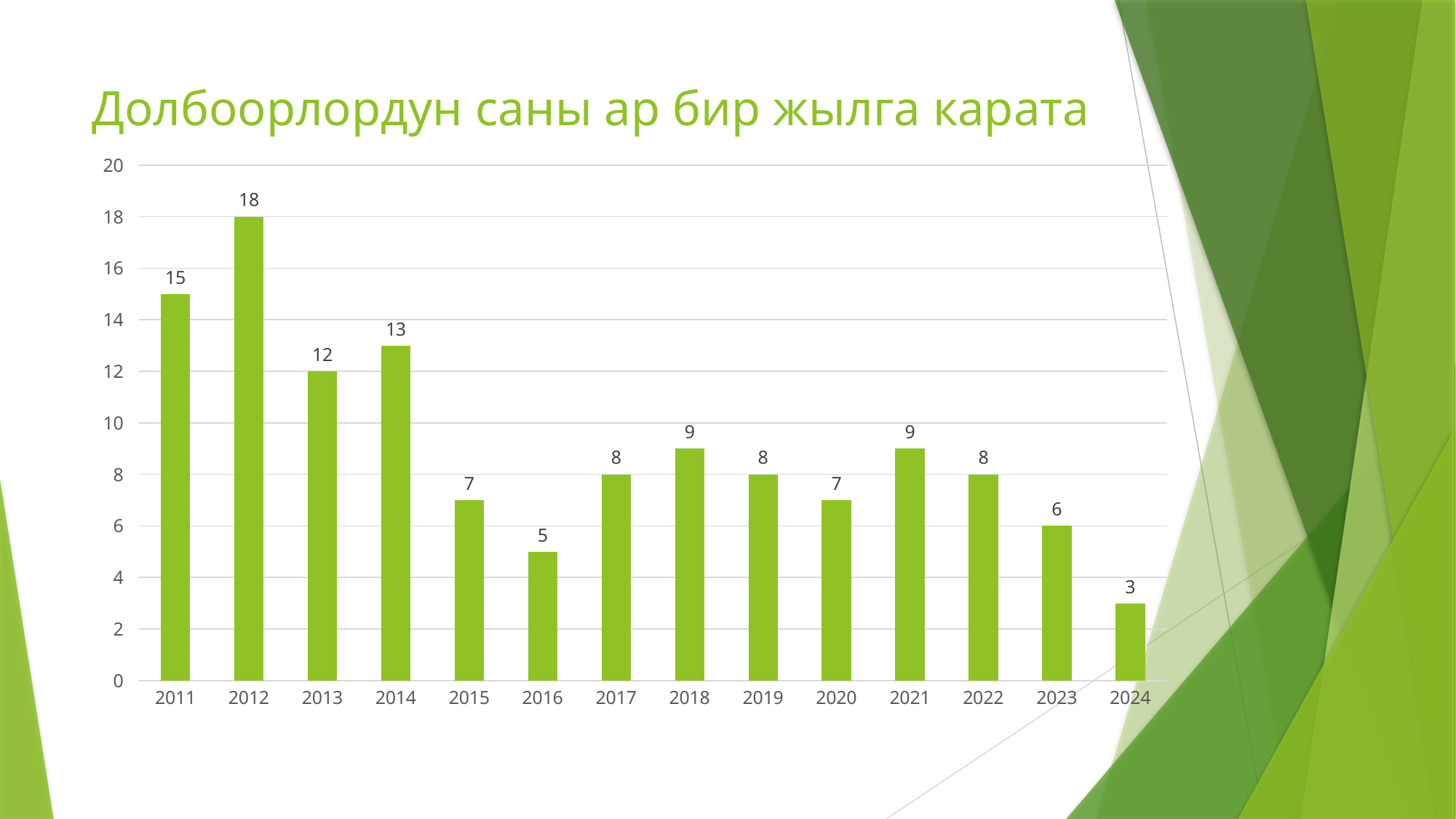
Which year has the highest value? 2012 What is the value for 2024? 3 What is the difference between the values for 2014 and 2015? 6 What is the value for 2016? 5 What is the difference between the values for 2012 and 2011? 3 Which is larger, the value for 2013 or the value for 2018? 2013 Which year has the lowest value? 2024 What kind of chart is shown on the slide? bar chart Is the value for 2011 greater or less than 10? greater What is the title of the chart? Долбоорлордун саны ар бир жылга карата How many years are shown on the x axis? 14 What is the value for 2012? 18